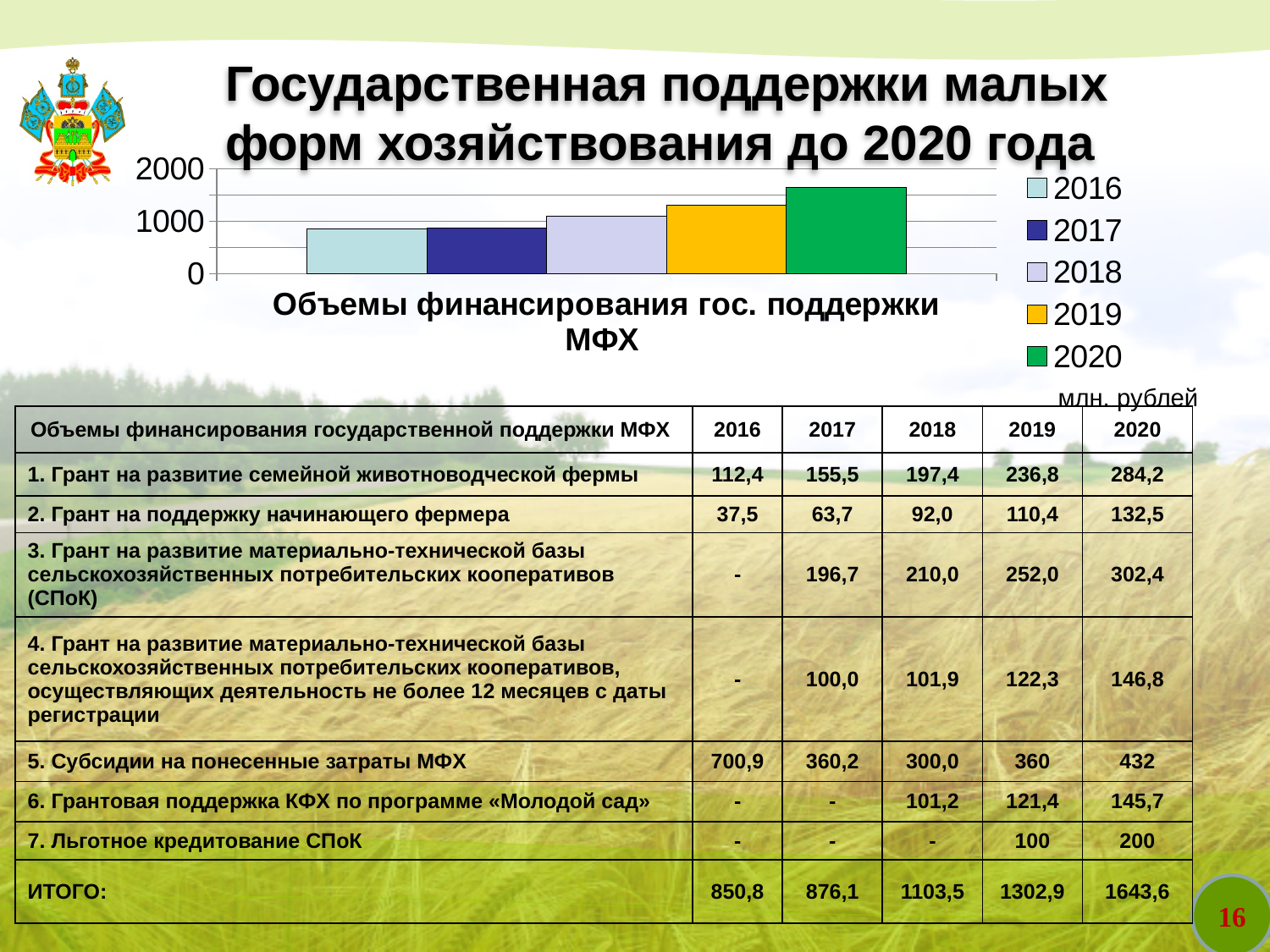
Which year has the highest bar in the chart? 2020 Is the value for 2019 in the chart greater or less than 1000? greater Is the value for 2016 in the chart greater or less than 1000? less Is the value for 2017 in the chart greater or less than 1000? less What colour is the 2020 series in the chart legend? green Do the bar values rise or fall from 2016 to 2020? rise Which bar is taller in the chart, 2019 or 2018? 2019 What is the category label shown under the bars of the chart? Объемы финансирования гос. поддержки МФХ How many series does the chart legend list? 5 How many categories are shown on the x axis of the chart? 1 What kind of chart is shown on the slide? bar chart